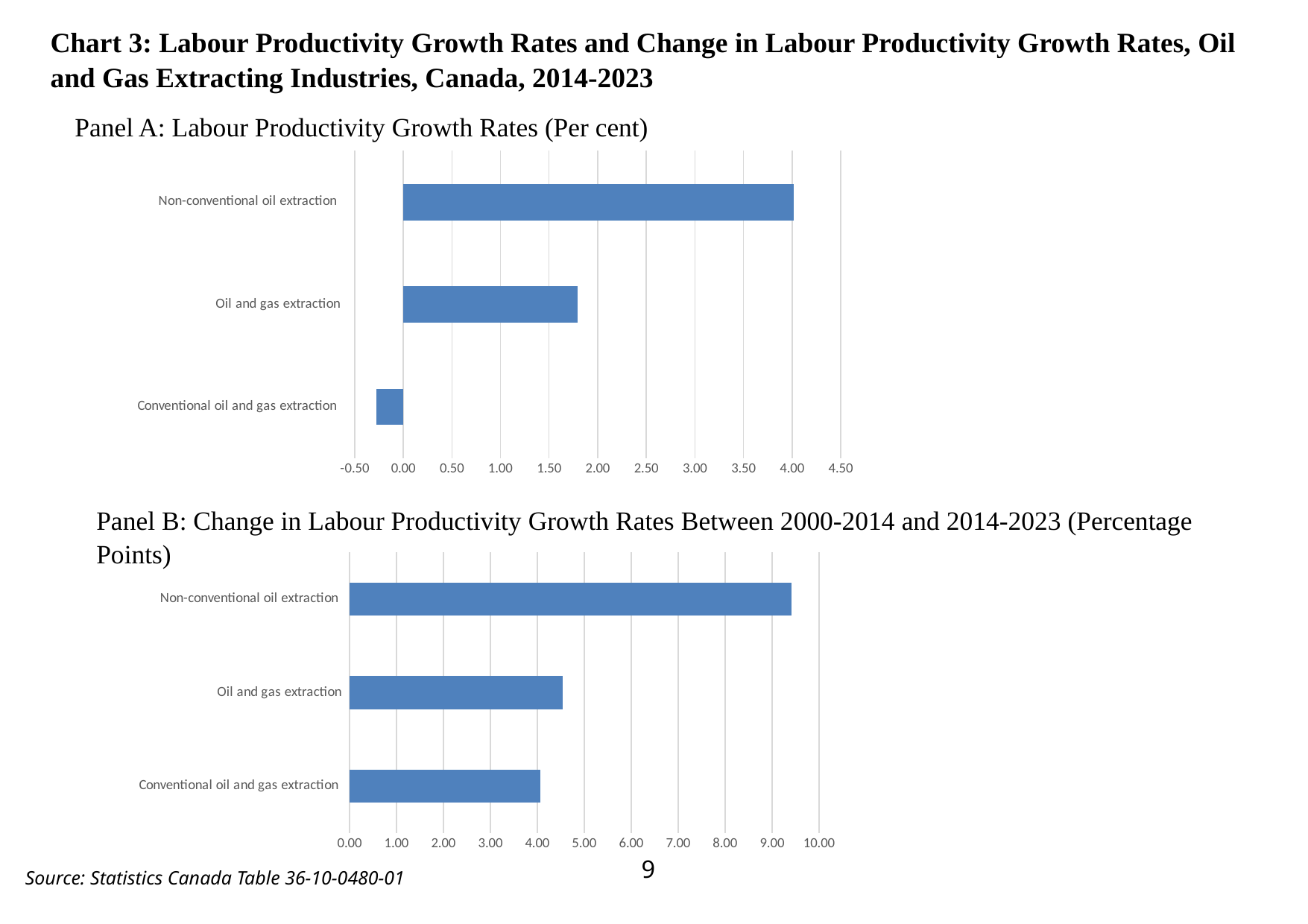
In Panel B: Change in Labour Productivity Growth Rates, is the value for Non-conventional oil extraction greater or less than 9.00? greater In Panel B: Change in Labour Productivity Growth Rates, which category has the highest value? Non-conventional oil extraction In Panel A: Labour Productivity Growth Rates, is the value for Oil and gas extraction greater or less than 1.50? greater In Panel A: Labour Productivity Growth Rates, is the value for Non-conventional oil extraction greater or less than 3.50? greater In Panel B: Change in Labour Productivity Growth Rates, which is larger, the value for Oil and gas extraction or the value for Conventional oil and gas extraction? Oil and gas extraction In Panel A: Labour Productivity Growth Rates, which category has the lowest value? Conventional oil and gas extraction How many categories are shown in Panel A: Labour Productivity Growth Rates? 3 In Panel A: Labour Productivity Growth Rates, which category has the highest value? Non-conventional oil extraction What kind of chart is Panel A: Labour Productivity Growth Rates? bar chart What unit is given in the title of Panel B? Percentage Points